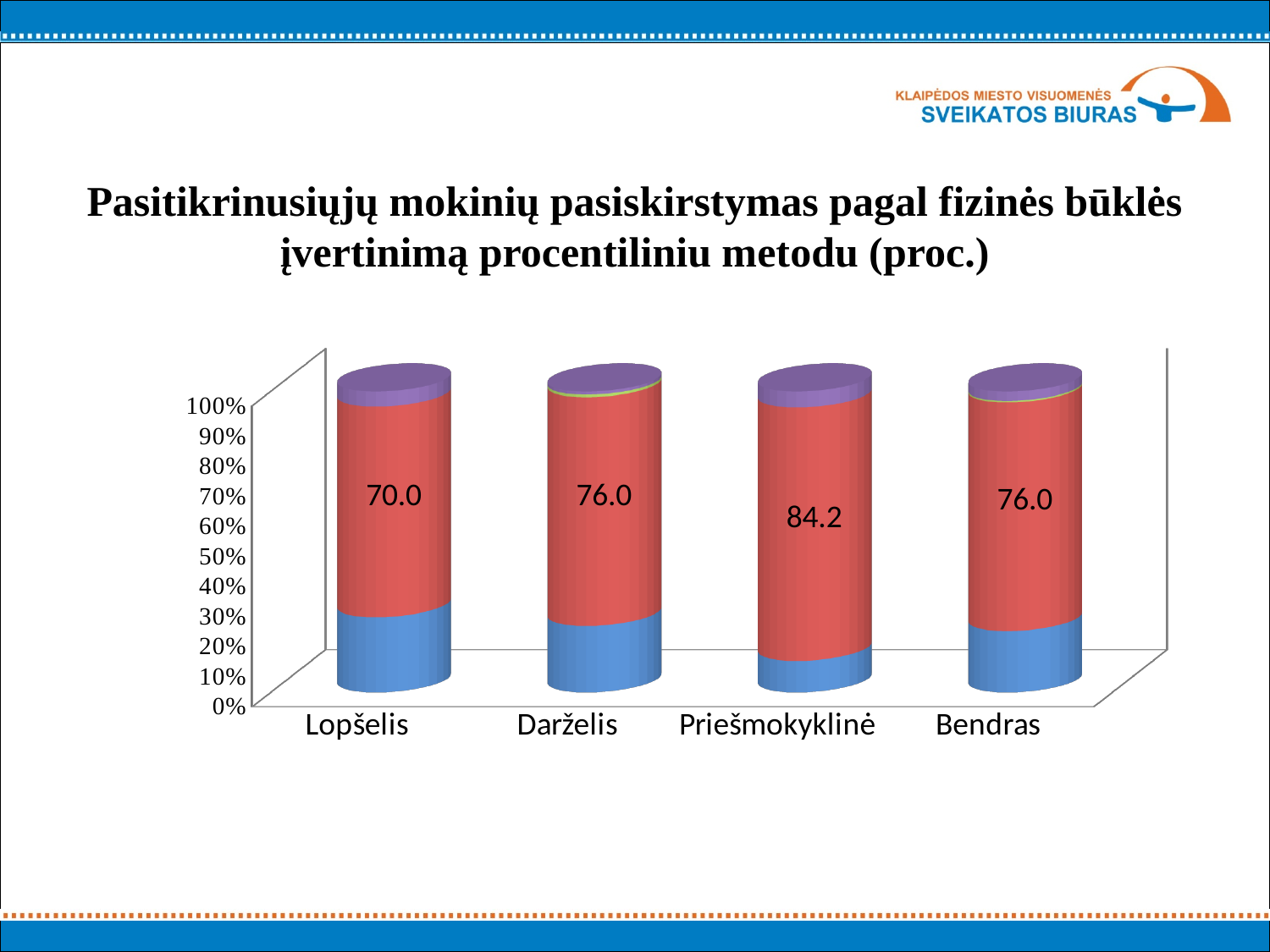
What is the value labelled on the red segment for Lopšelis? 70.0 Is the blue segment for Priešmokyklinė greater or less than 30%? less What kind of chart is shown on the slide? Stacked bar chart What is the value labelled on the red segment for Darželis? 76.0 What is the difference between the labelled red-segment values for Priešmokyklinė and Lopšelis? 14.2 What is the value labelled on the red segment for Priešmokyklinė? 84.2 Which has a larger labelled red-segment value, Priešmokyklinė or Darželis? Priešmokyklinė What is the title of the chart on the slide? Pasitikrinusiųjų mokinių pasiskirstymas pagal fizinės būklės įvertinimą procentiliniu metodu (proc.) What is the value labelled on the red segment for Bendras? 76.0 Which category has the lowest labelled red-segment value? Lopšelis Which category has the highest labelled red-segment value? Priešmokyklinė How many categories are shown on the x axis? 4